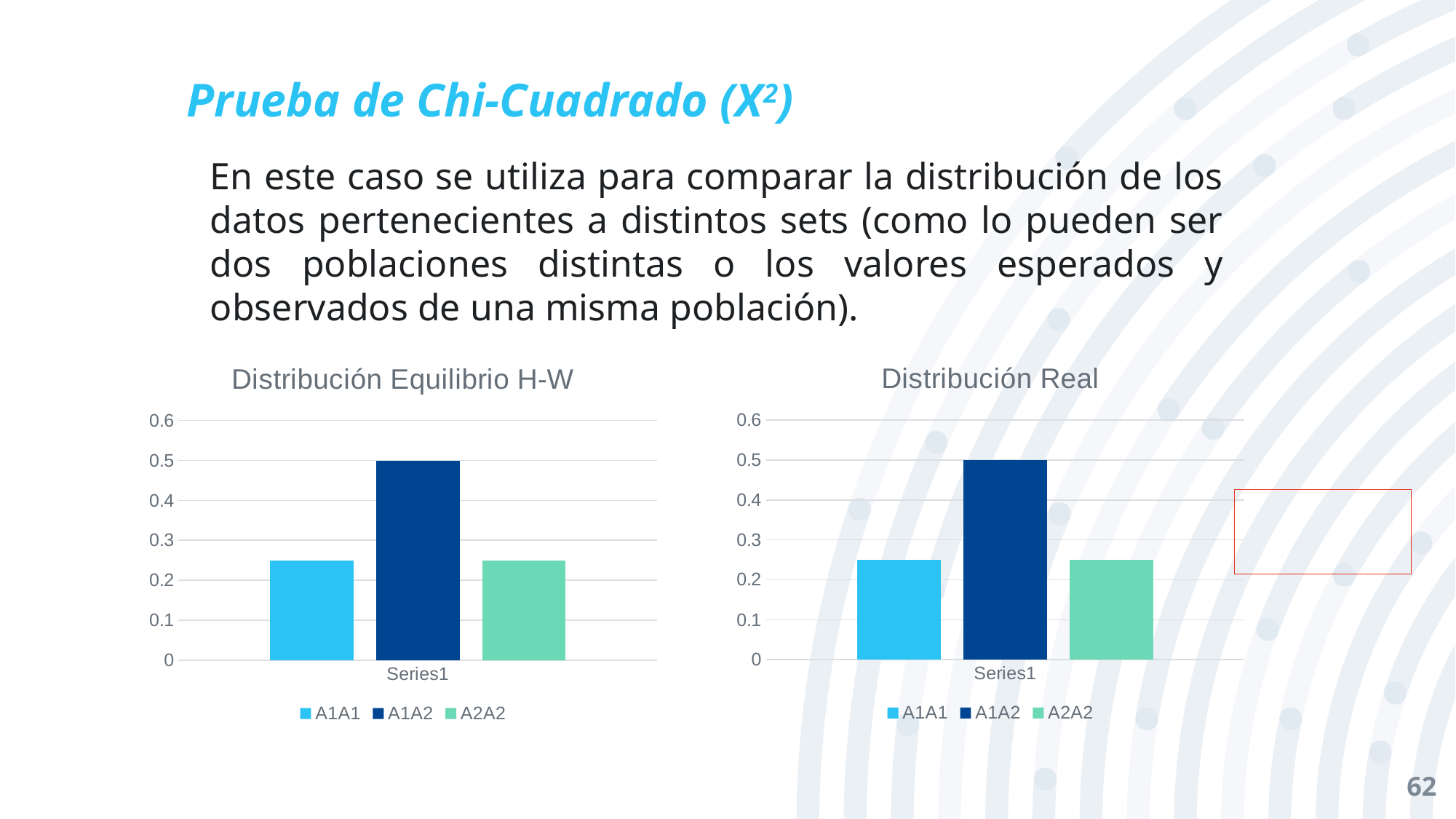
In the 'Distribución Real' chart, what is the value for A1A2? 0.5 In the 'Distribución Real' chart, which is larger, the value for A1A2 or the value for A2A2? A1A2 In the 'Distribución Equilibrio H-W' chart, what kind of chart is shown? bar chart In the 'Distribución Equilibrio H-W' chart, is the value for A2A2 greater or less than 0.2? greater In the 'Distribución Equilibrio H-W' chart, what is the value for A1A2? 0.5 In the 'Distribución Real' chart, how many series does the legend list? 3 In the 'Distribución Real' chart, is the value for A1A1 greater or less than 0.3? less In the 'Distribución Real' chart, which series has the highest bar? A1A2 In the 'Distribución Equilibrio H-W' chart, how many series does the legend list? 3 In the 'Distribución Equilibrio H-W' chart, is the value for A1A1 greater or less than 0.3? less In the 'Distribución Equilibrio H-W' chart, which series has the highest bar? A1A2 In the 'Distribución Real' chart, what is the label on the x axis under the bars? Series1